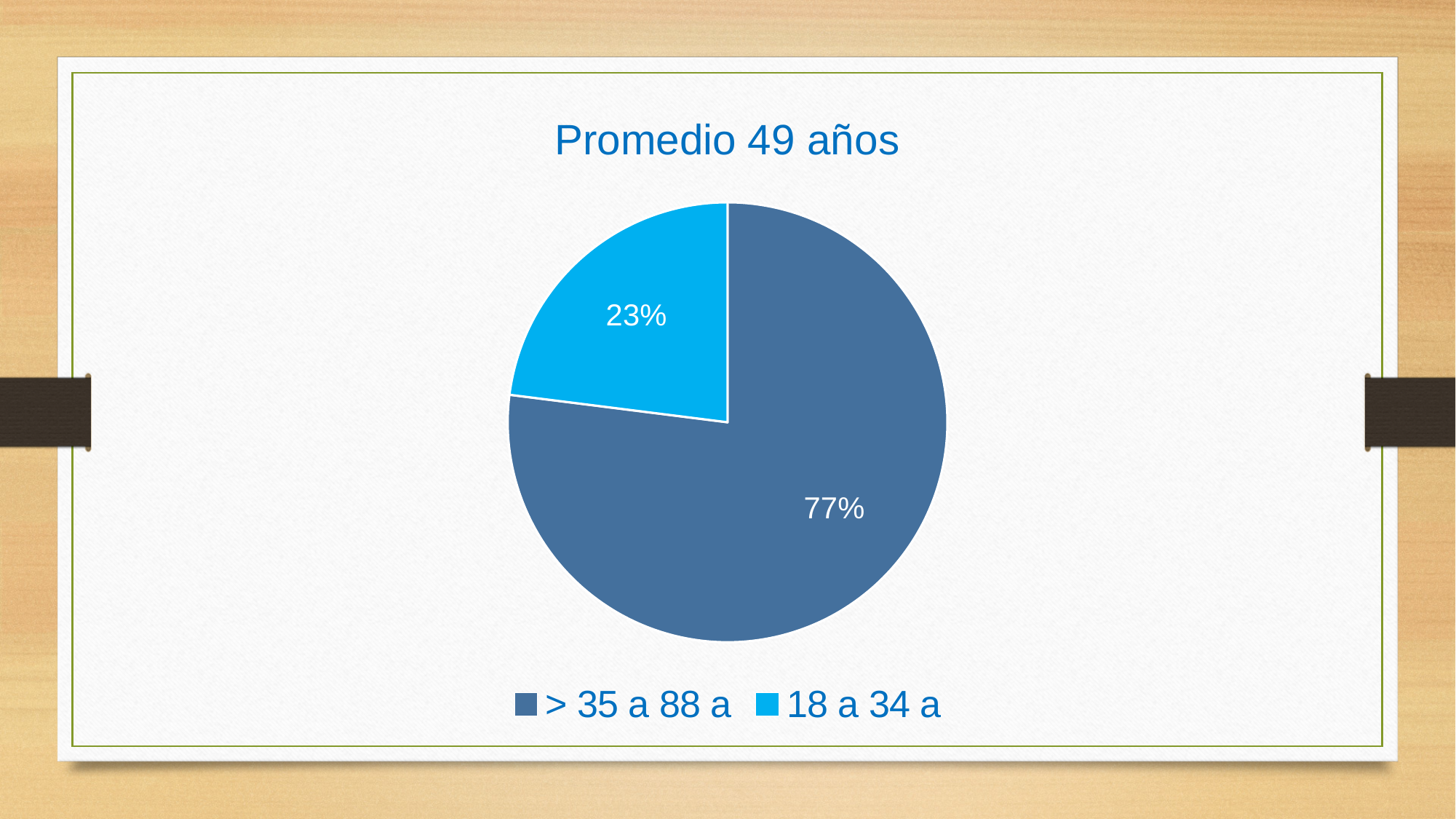
What share of the pie does the "> 35 a 88 a" slice represent? 77% What is the title of the chart? Promedio 49 años Which category is shown in the lighter blue colour? 18 a 34 a Which category has the smallest slice of the pie? 18 a 34 a How many slices does the pie chart have? 2 How many entries does the legend list? 2 What share of the pie does the "18 a 34 a" slice represent? 23% What kind of chart is shown on the slide? pie chart Which category has the largest slice of the pie? > 35 a 88 a Which slice is larger, "> 35 a 88 a" or "18 a 34 a"? > 35 a 88 a What is the difference in percentage points between the "> 35 a 88 a" slice and the "18 a 34 a" slice? 54